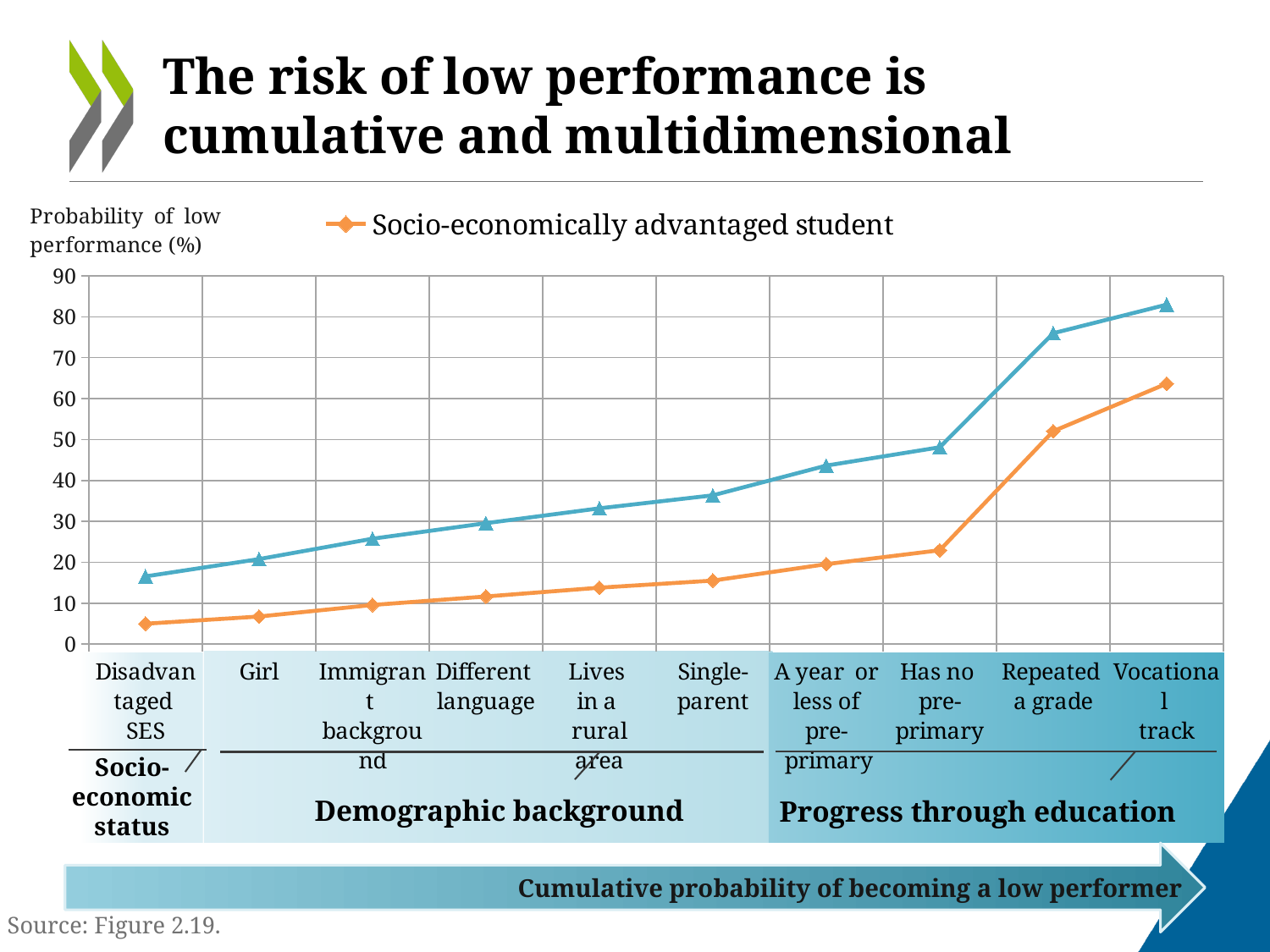
Do the values of the Socio-economically advantaged student line rise or fall from left to right along the x axis? rise What kind of chart is shown on the slide? line chart For the Socio-economically advantaged student line, which category has the highest probability of low performance? Vocational track Is the value for Disadvantaged SES on the Socio-economically advantaged student line greater or less than 10? less Is the value for Repeated a grade on the Socio-economically advantaged student line greater or less than 50? greater Is the value for Vocational track on the upper (blue) line greater or less than 80? greater How many categories are shown along the x axis of the chart? 10 At Vocational track, which line has the higher value: the blue line or the orange Socio-economically advantaged student line? the blue line What is the label of the vertical axis of the chart? Probability of low performance (%) What is the title of the slide containing the chart? The risk of low performance is cumulative and multidimensional For the Socio-economically advantaged student line, which category has the lowest probability of low performance? Disadvantaged SES